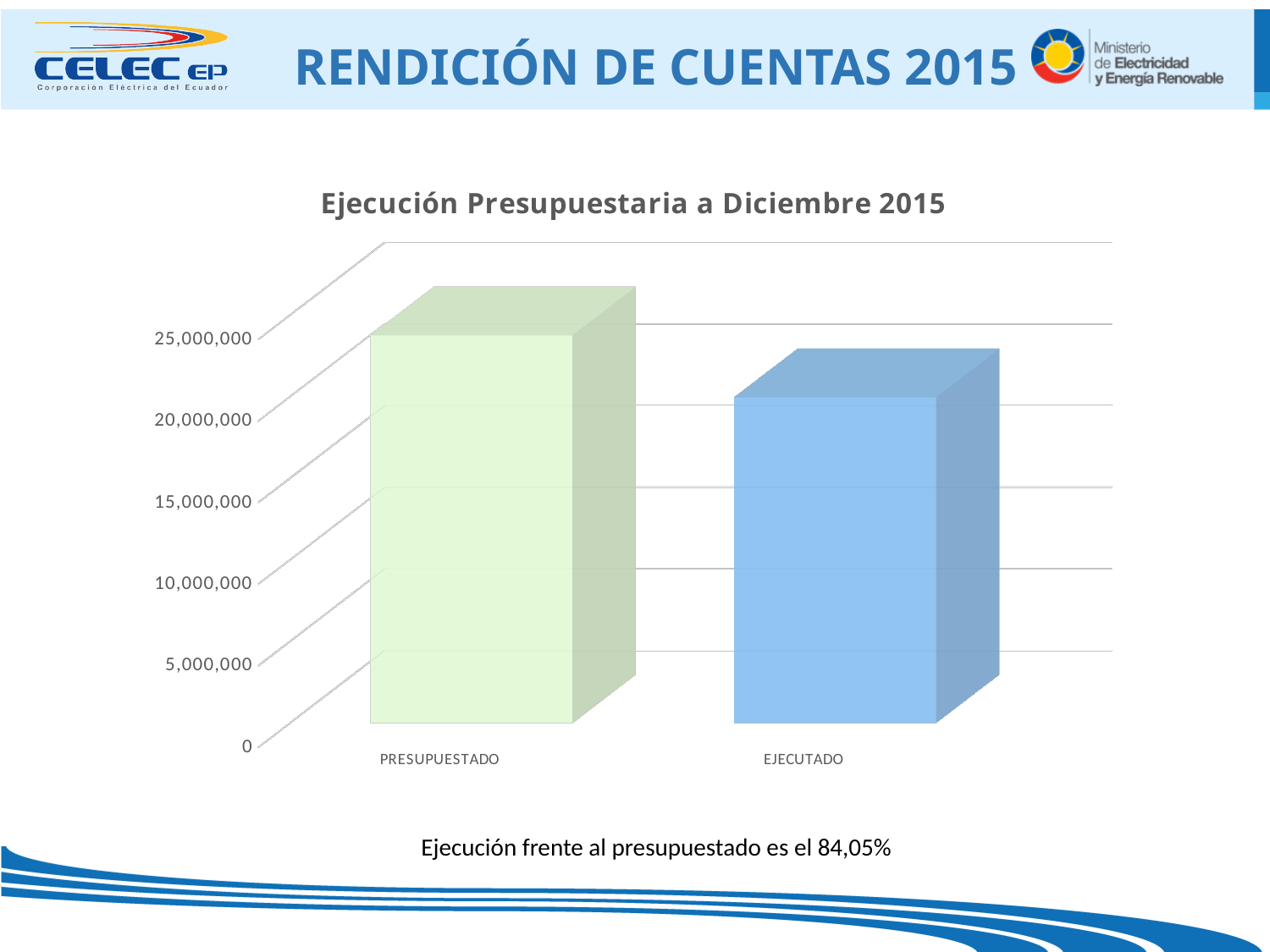
Is the value for PRESUPUESTADO greater or less than 20,000,000? greater What is the title of the chart? Ejecución Presupuestaria a Diciembre 2015 Which category has the highest value? PRESUPUESTADO Which category has the lowest value? EJECUTADO What is the highest value shown on the vertical axis? 25,000,000 Is the value for EJECUTADO greater or less than 15,000,000? greater What type of chart is shown on the slide? bar chart Is the value for EJECUTADO greater or less than 25,000,000? less Which is larger, the value for PRESUPUESTADO or the value for EJECUTADO? PRESUPUESTADO How many categories are plotted in the chart? 2 Do the values rise or fall from PRESUPUESTADO to EJECUTADO along the x axis? fall